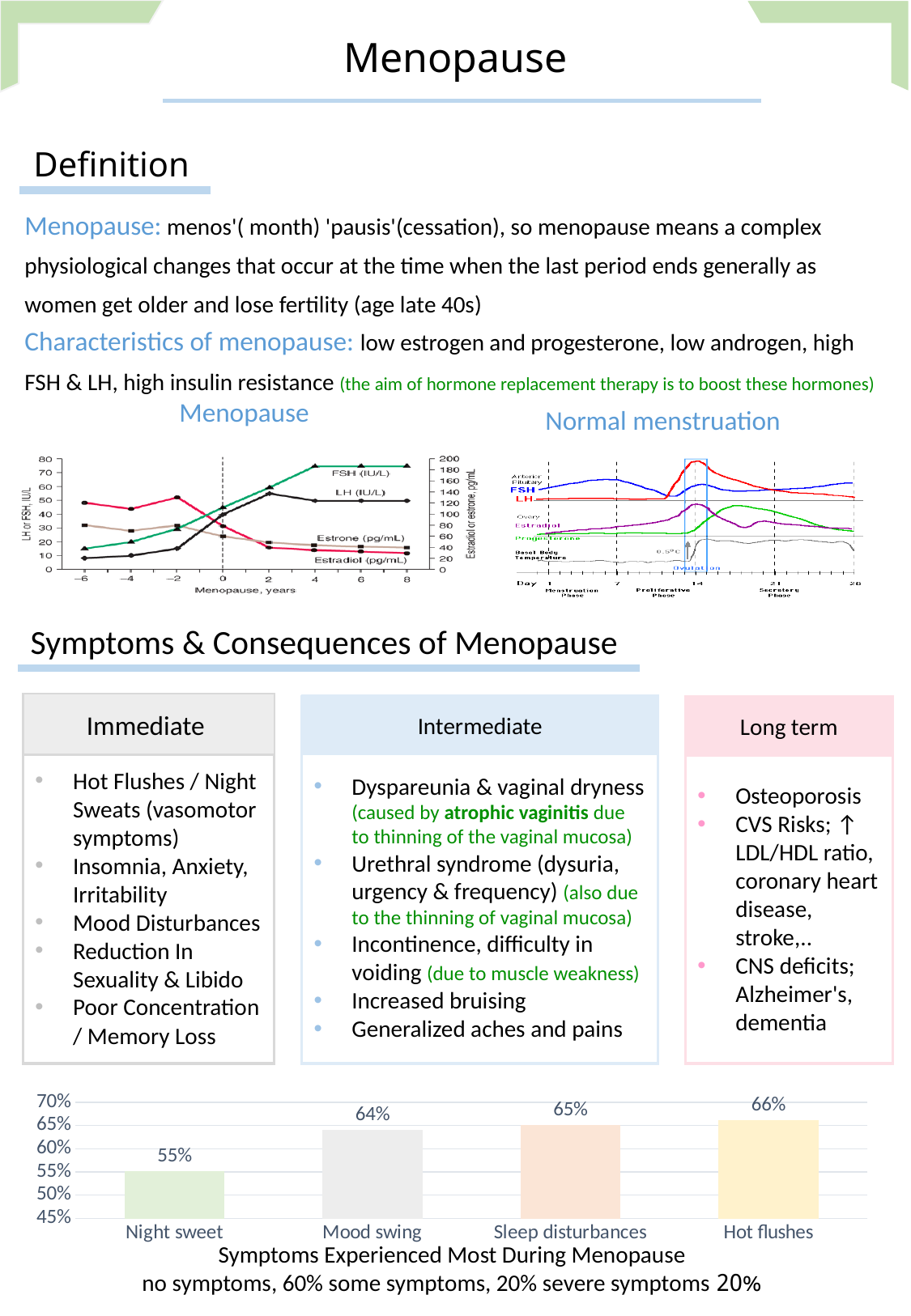
In the bar chart at the bottom of the slide, what is the value for Sleep disturbances? 65% In the bar chart at the bottom of the slide, what is the value for Hot flushes? 66% In the bar chart at the bottom of the slide, which is larger, the value for Mood swing or the value for Night sweet? Mood swing In the bar chart at the bottom of the slide, what is the value for Night sweet? 55% How many categories are shown in the bar chart at the bottom of the slide? 4 In the bar chart at the bottom of the slide, what is the difference between the values for Hot flushes and Night sweet? 11% In the 'Menopause' line chart, how many hormone series are labelled? 4 What is the title of the bar chart at the bottom of the slide? Symptoms Experienced Most During Menopause In the bar chart at the bottom of the slide, which symptom has the highest value? Hot flushes In the bar chart at the bottom of the slide, which symptom has the lowest value? Night sweet In the bar chart at the bottom of the slide, what is the value for Mood swing? 64% What kind of chart is shown at the bottom of the slide? Bar chart